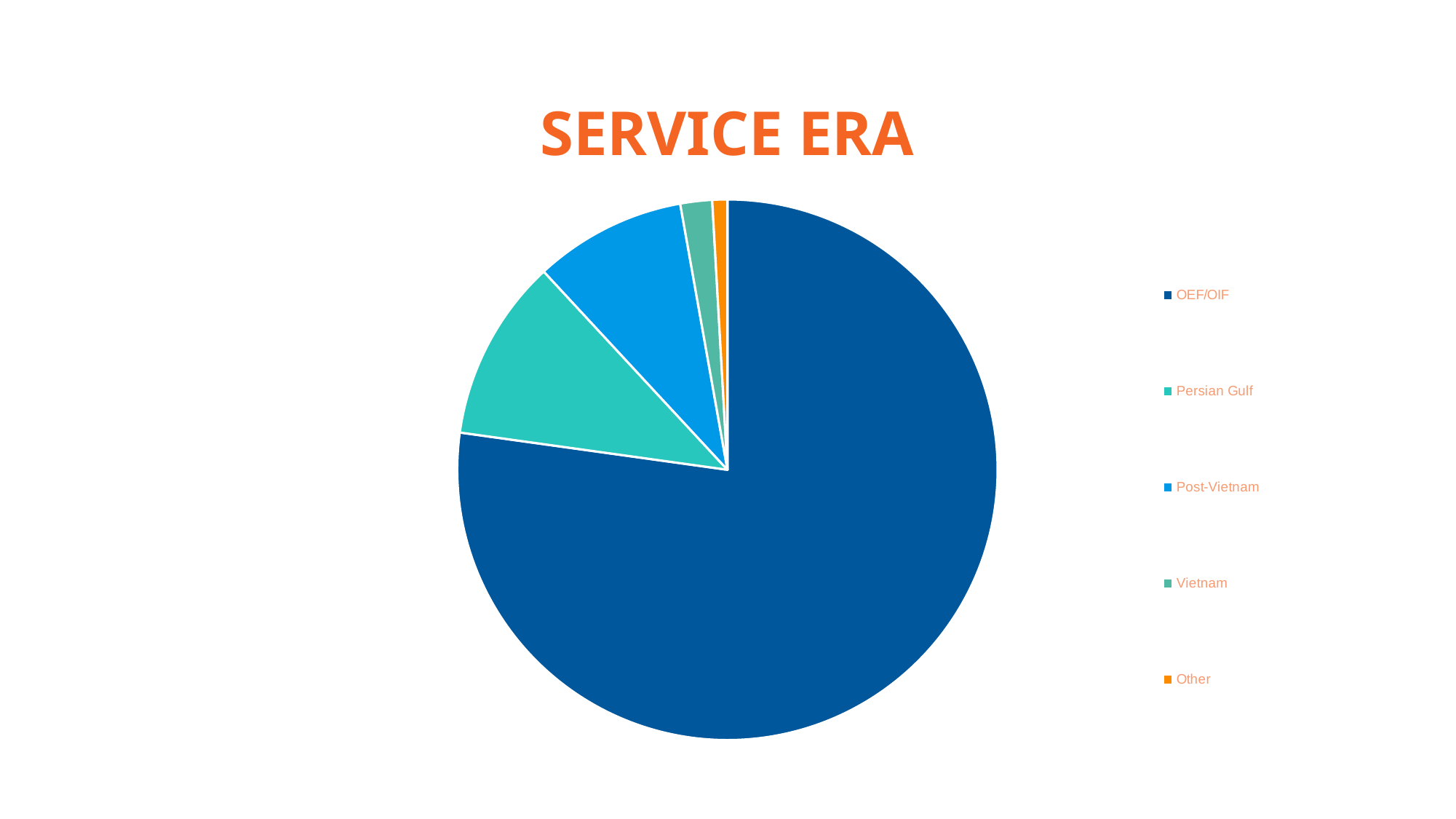
How many entries does the legend list? 5 Does the OEF/OIF slice take up more or less than half of the pie? more Which slice is larger, Post-Vietnam or Vietnam? Post-Vietnam How many slices does the pie chart have? 5 Which slice is larger, Persian Gulf or Post-Vietnam? Persian Gulf Which service era has the smallest slice of the pie? Other What is the title of the chart? SERVICE ERA Which service era has the largest slice of the pie? OEF/OIF What kind of chart is shown on the slide? pie chart Which slice is larger, Vietnam or Other? Vietnam Which legend entry is shown in orange? Other